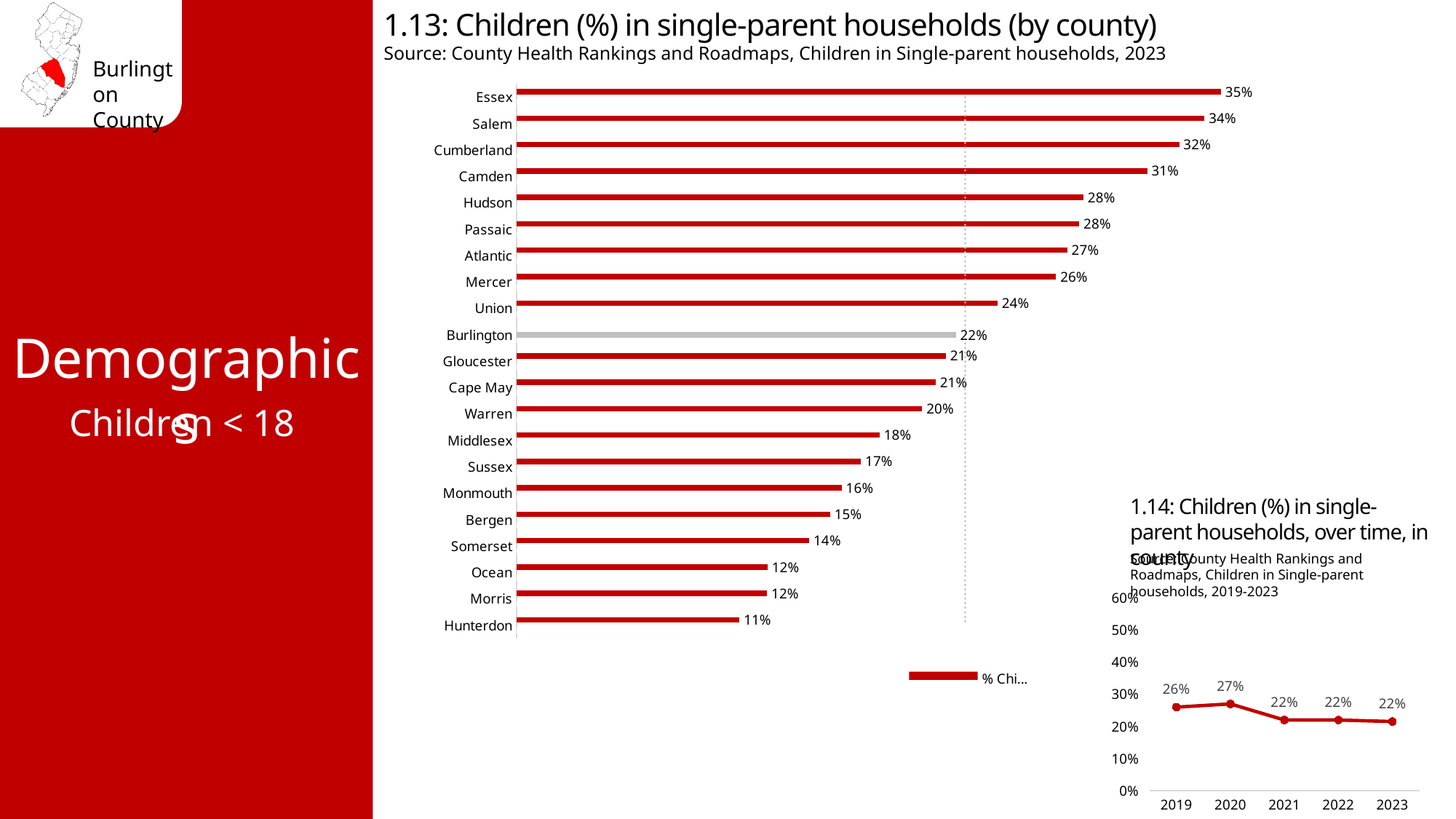
What kind of chart is chart 1.14? Line chart In chart 1.13, what is the value for Camden? 31% How many counties are shown in chart 1.13? 21 What kind of chart is chart 1.13? Bar chart In chart 1.13, what is the difference between the values for Essex and Burlington? 13% In chart 1.13, which county has the highest percentage of children in single-parent households? Essex In chart 1.13 (Children (%) in single-parent households by county), what is the value for Burlington? 22% In chart 1.13, which county has the lowest percentage of children in single-parent households? Hunterdon In chart 1.14, what is the value for 2023? 22% In chart 1.13, which is larger, the value for Mercer or the value for Union? Mercer In chart 1.14, do the values rise or fall from 2020 to 2021? Fall In chart 1.14 (Children (%) in single-parent households over time), what is the value for 2020? 27%